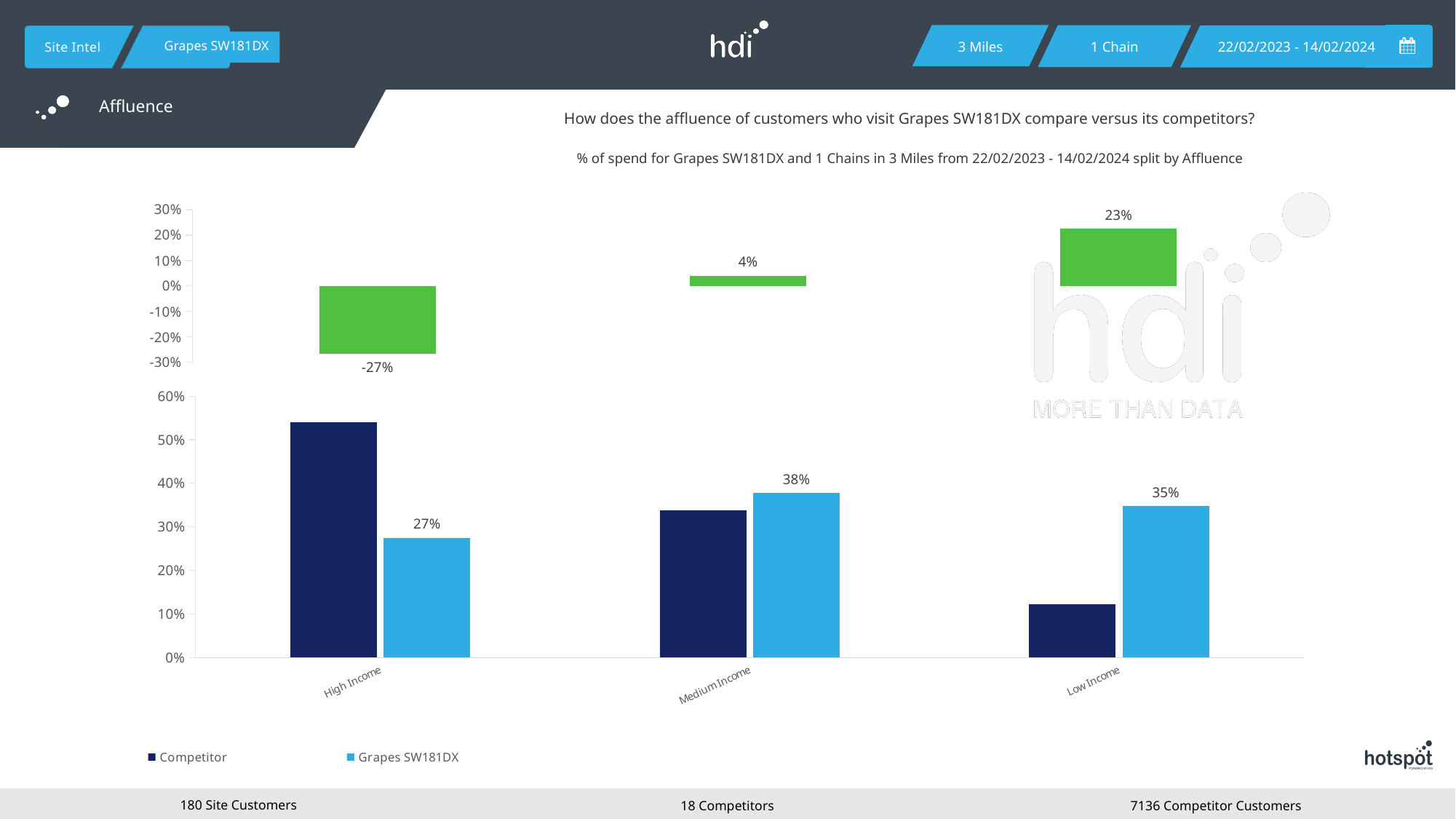
In the bottom chart, is the Competitor value for Low Income greater or less than 20%? less In the bottom chart, what is the value for Grapes SW181DX in the Medium Income category? 38% In the bottom chart, which category has the highest value for Grapes SW181DX? Medium Income In the top chart, what is the value shown for the Low Income category? 23% In the bottom chart, what is the value for Grapes SW181DX in the Low Income category? 35% In the bottom chart, is the Competitor value for High Income greater or less than 50%? greater In the top chart, what is the value shown for the High Income category? -27% In the bottom chart, what is the difference between the Grapes SW181DX values for Medium Income and High Income? 11% In the top chart, which category has the lowest value? High Income In the bottom chart, what is the value for Grapes SW181DX in the High Income category? 27% In the bottom chart, which is larger for Low Income: Competitor or Grapes SW181DX? Grapes SW181DX How many series does the legend of the bottom chart list? 2